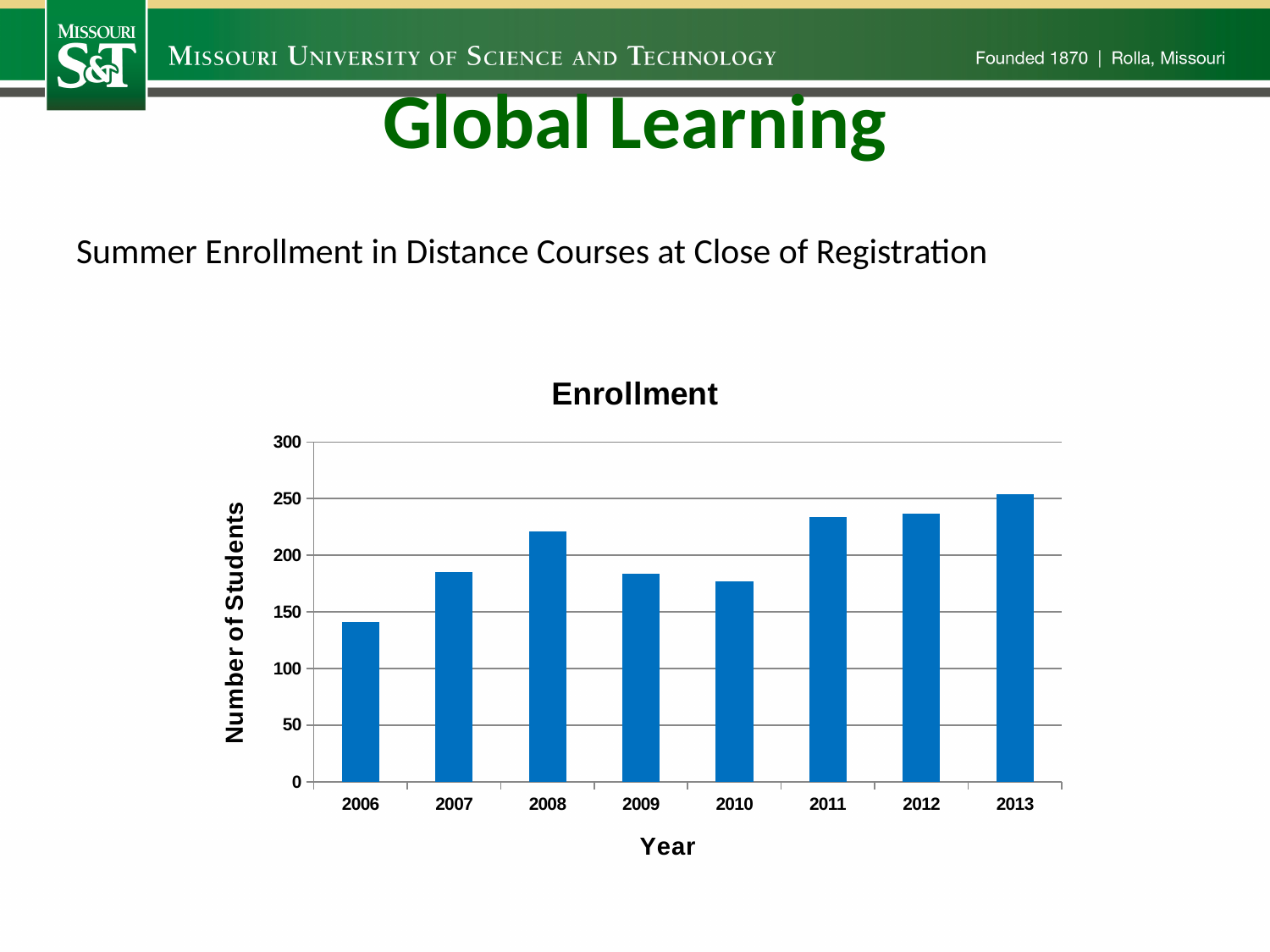
What kind of chart is shown on the slide? bar chart Is the value for 2010 greater or less than 200? less Which year has the larger enrollment, 2008 or 2009? 2008 Is the value for 2008 greater or less than 200? greater What is the title of the chart? Enrollment Which year has the lowest enrollment in the Enrollment chart? 2006 Which year has the highest enrollment in the Enrollment chart? 2013 What is the label on the y axis of the chart? Number of Students Is the value for 2006 greater or less than 150? less Do the values rise or fall from 2010 to 2013? rise How many years are plotted on the x axis of the Enrollment chart? 8